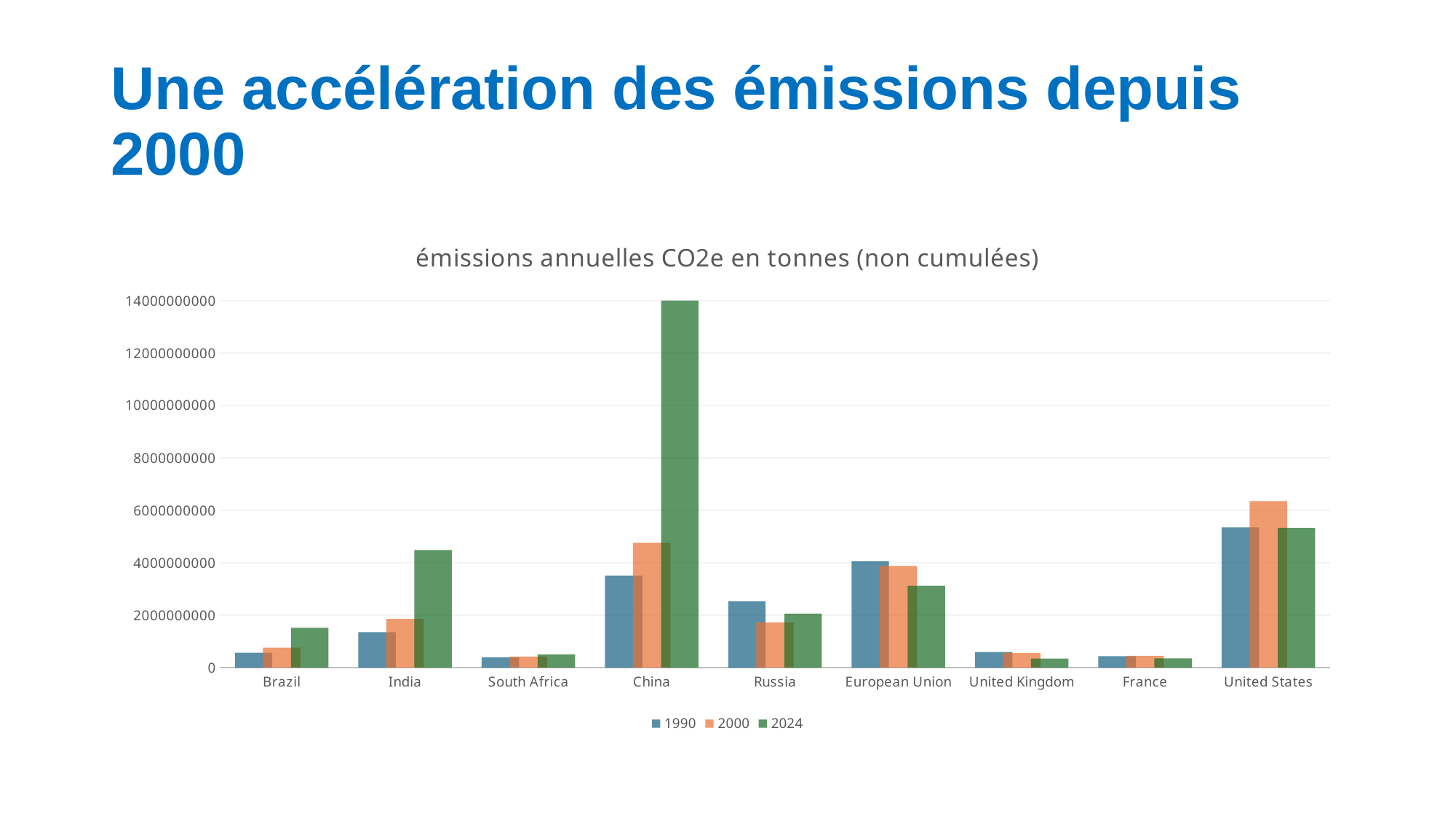
What kind of chart is shown on the slide? bar chart What is the title of the chart? émissions annuelles CO2e en tonnes (non cumulées) Which is larger for Brazil, the 2000 value or the 2024 value? 2024 Is the 2024 value for India greater or less than 4000000000? greater Which is larger for Russia, the 1990 value or the 2024 value? 1990 Which category has the lowest 1990 value? South Africa How many countries or regions are shown on the x axis? 9 Is the 2024 value for China greater or less than 12000000000? greater How many series does the legend list? 3 Is the 2000 value for United States greater or less than 6000000000? greater Which category has the highest 2024 value? China